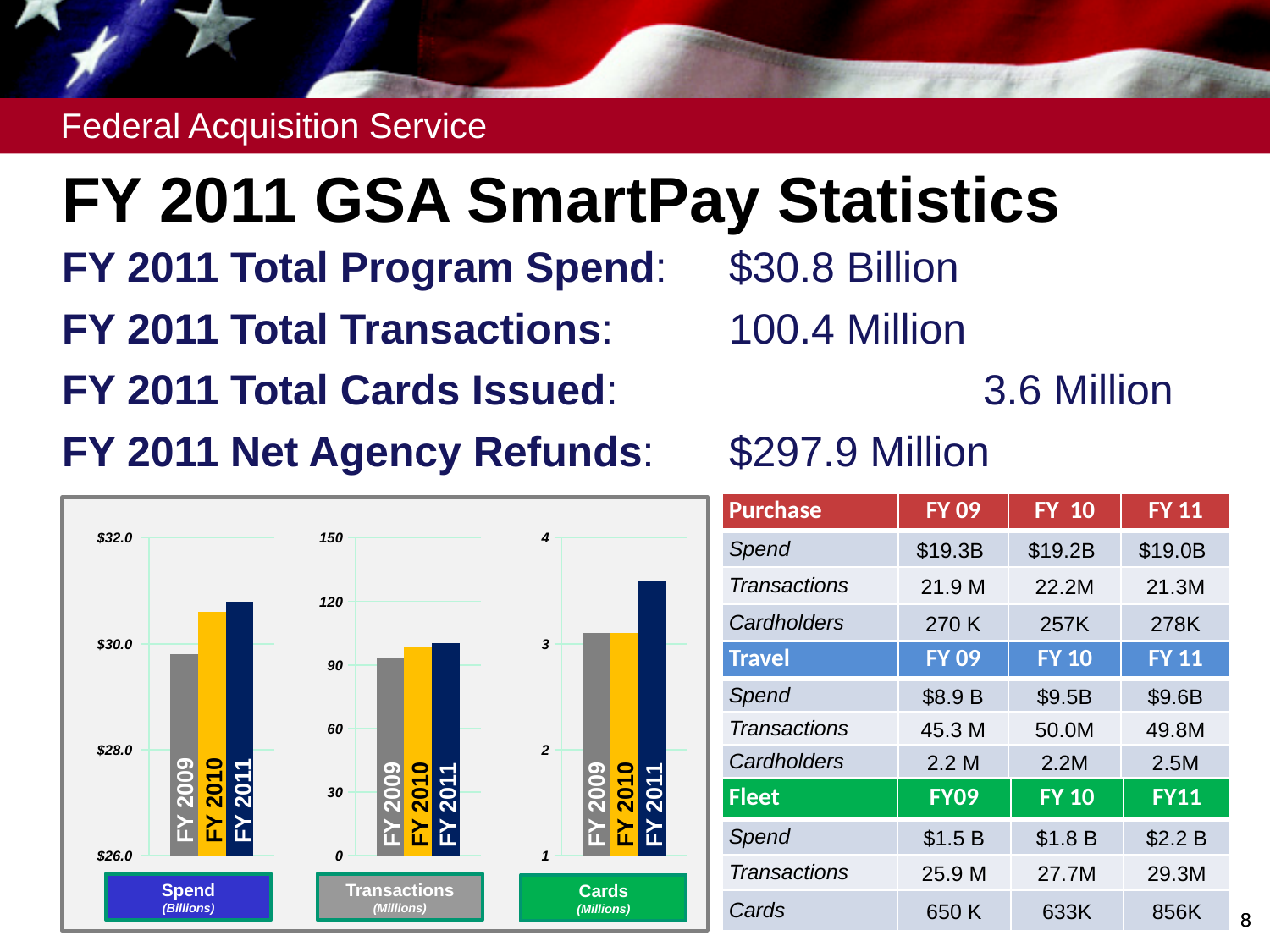
In the Spend (Billions) chart, is the value for FY 2009 greater or less than $30.0? less In the Spend (Billions) chart, do the values rise or fall from FY 2009 to FY 2011? rise In the Cards (Millions) chart, which fiscal year has the highest bar? FY 2011 In the Transactions (Millions) chart, which is larger, the value for FY 2009 or FY 2011? FY 2011 In the Cards (Millions) chart, is the value for FY 2011 greater or less than 4? less In the Transactions (Millions) chart, is the value for FY 2011 greater or less than 120? less In the Transactions (Millions) chart, which fiscal year has the lowest bar? FY 2009 What kind of chart is the Spend (Billions) chart? bar chart In the Spend (Billions) chart, which fiscal year has the lowest bar? FY 2009 How many bars does the Cards (Millions) chart show? 3